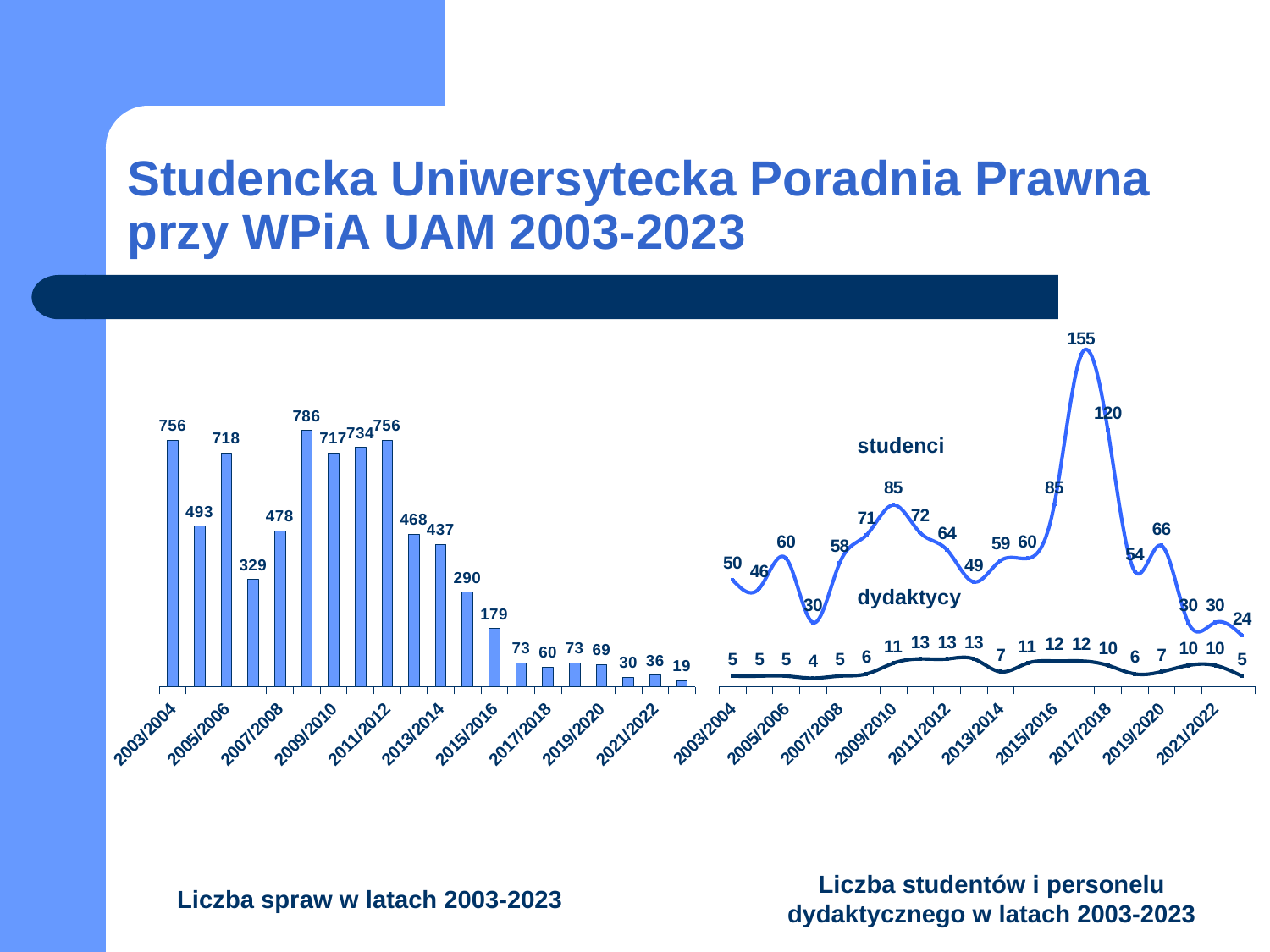
In the right chart, what is the highest value of the 'studenci' series? 155 In the right chart, which series has the larger value for 2003/2004, 'studenci' or 'dydaktycy'? studenci What kind of chart is the right chart, 'Liczba studentów i personelu dydaktycznego w latach 2003-2023'? line chart How many bars are plotted in the left chart 'Liczba spraw w latach 2003-2023'? 20 In the left chart 'Liczba spraw w latach 2003-2023', what is the highest value shown? 786 How many series are shown in the right chart 'Liczba studentów i personelu dydaktycznego w latach 2003-2023'? 2 What kind of chart is the left chart, 'Liczba spraw w latach 2003-2023'? bar chart In the right chart, what is the lowest value of the 'dydaktycy' series? 4 In the left chart 'Liczba spraw w latach 2003-2023', what is the difference between the highest and the lowest value? 767 In the left chart 'Liczba spraw w latach 2003-2023', do the values overall rise or fall from left to right? fall In the left chart 'Liczba spraw w latach 2003-2023', what is the value for 2003/2004? 756 In the left chart 'Liczba spraw w latach 2003-2023', what is the lowest value shown? 19